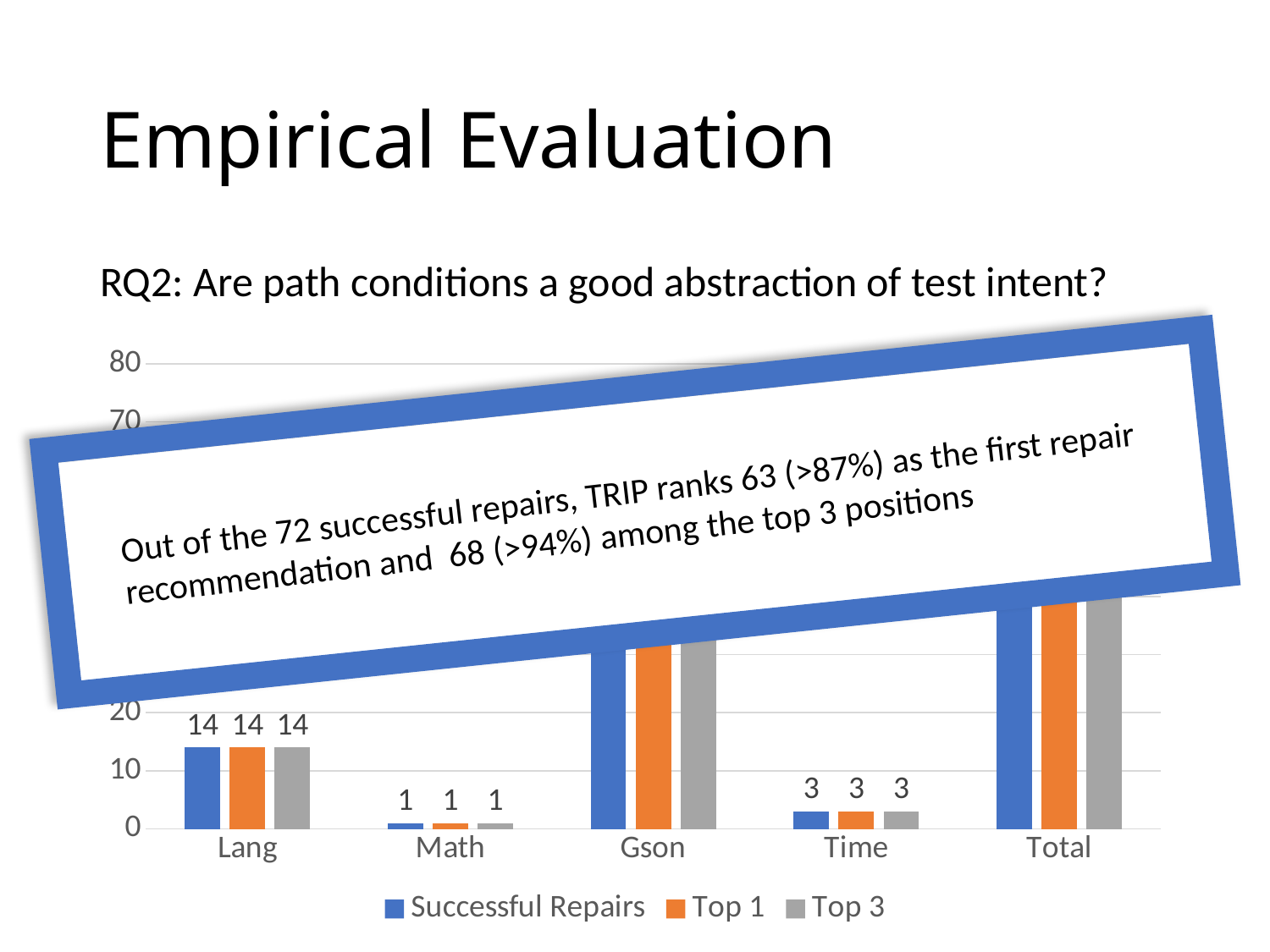
How many series does the chart legend list? 3 What is the value of Top 1 for Time? 3 What kind of chart is shown on the slide? bar chart Which series is shown in orange in the chart legend? Top 1 Which category has the lowest Successful Repairs value? Math What is the difference between the Successful Repairs value for Lang and for Time? 11 Is the Top 3 value for Gson greater or less than 20? greater What is the value of Successful Repairs for Lang? 14 How many categories are shown on the x axis of the chart? 5 Which category has the highest Successful Repairs value? Total Which is larger, the Top 1 value for Lang or the Top 1 value for Time? Lang What is the value of Top 3 for Math? 1